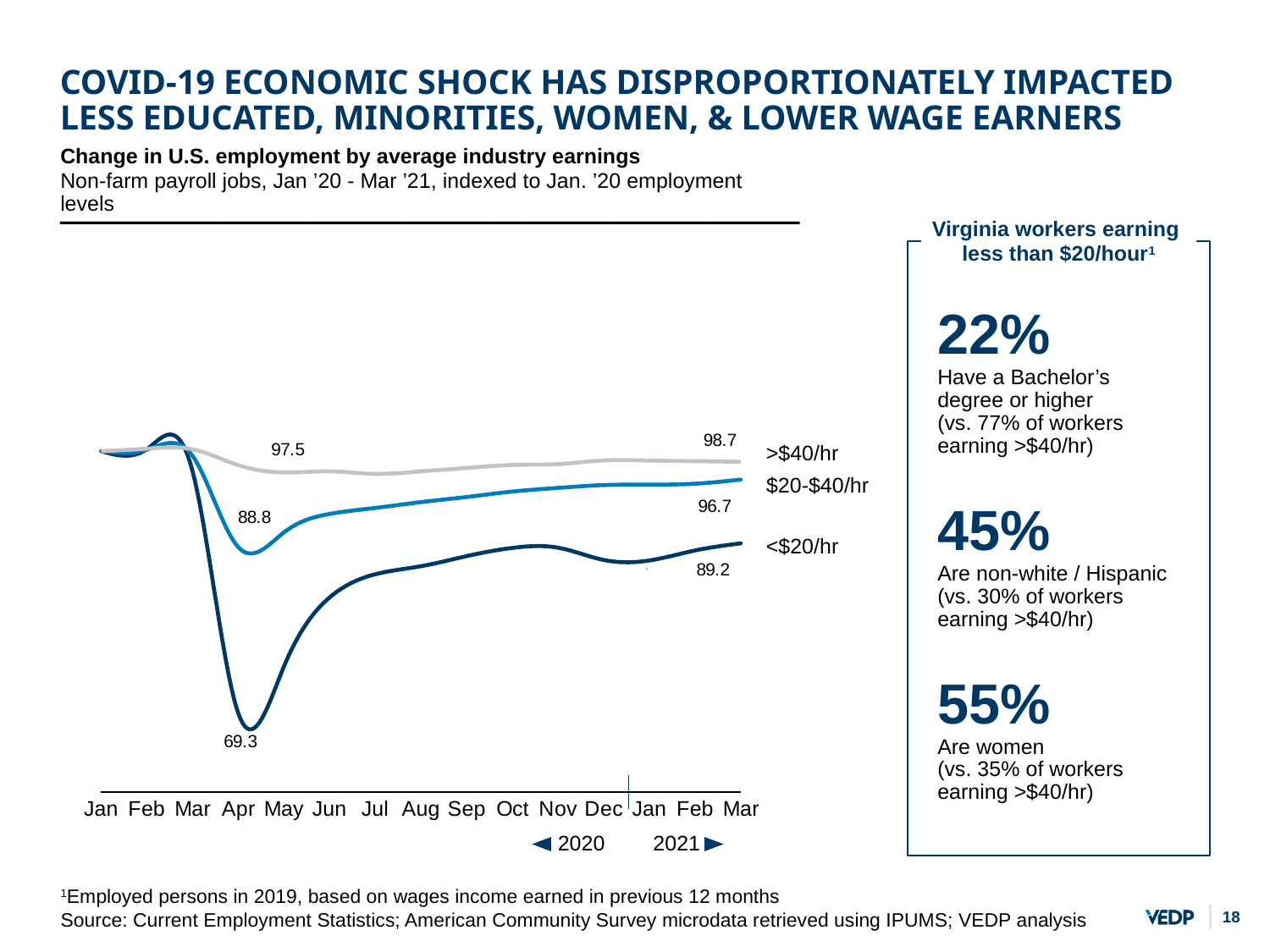
What is the labelled value for the >$40/hr series in March 2021? 98.7 Which series has the lowest labelled value in April 2020? <$20/hr What is the labelled value for the $20-$40/hr series in April 2020? 88.8 What is the labelled value for the <$20/hr series in April 2020? 69.3 Which is larger in March 2021: the $20-$40/hr value or the <$20/hr value? $20-$40/hr Which series has the highest labelled value in March 2021? >$40/hr How many months are labelled on the x axis? 15 How many series are plotted in the chart? 3 What is the labelled value for the <$20/hr series in March 2021? 89.2 What kind of chart is shown on the slide? Line chart